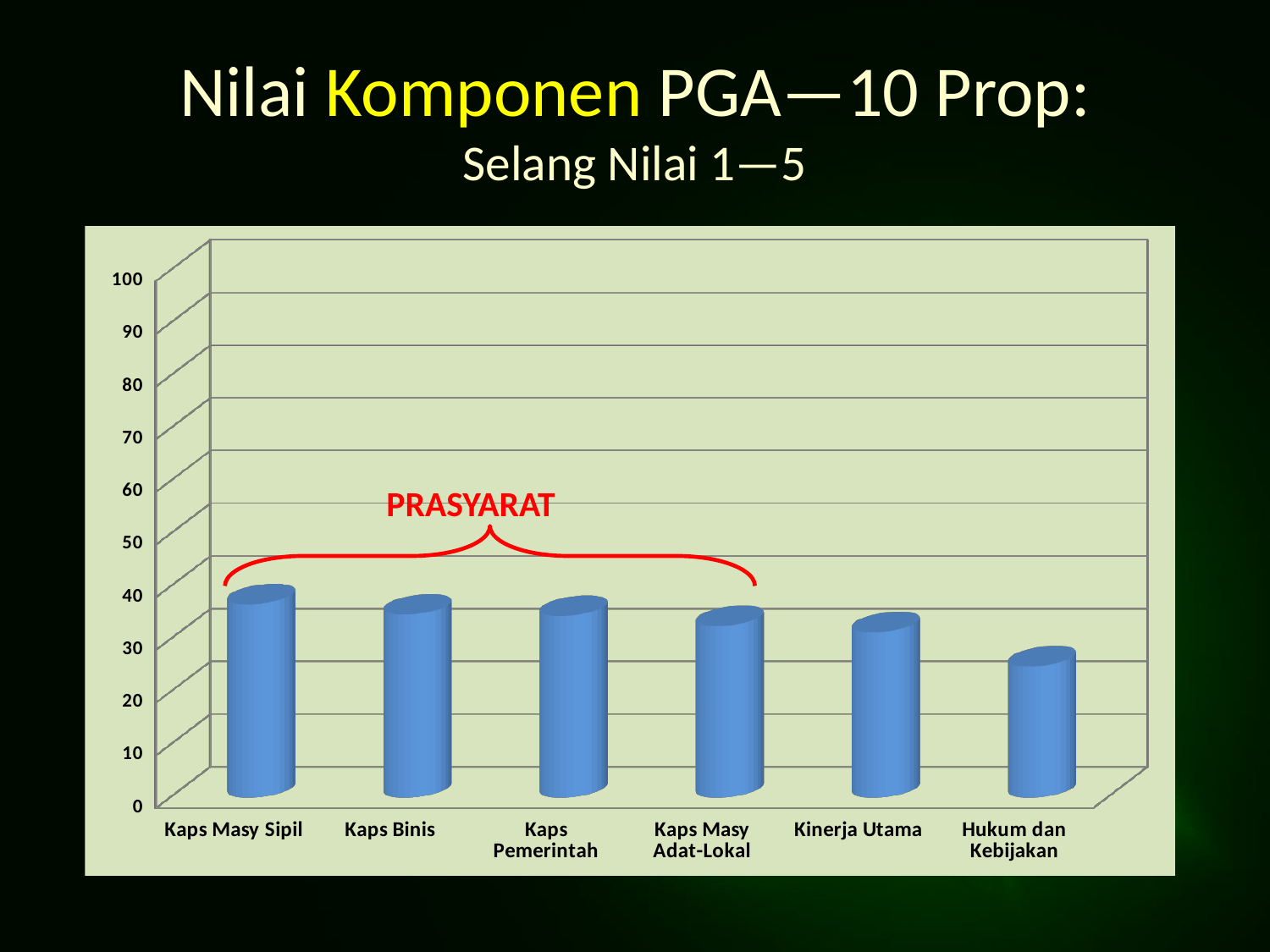
Which is larger, the value for Kaps Masy Sipil or the value for Kinerja Utama? Kaps Masy Sipil What label is written in red above the bracket grouping the first four bars? PRASYARAT What kind of chart is shown on the slide? Bar chart Do the bar values generally rise or fall from left to right along the x axis? Fall Is the value for Hukum dan Kebijakan greater or less than 20? greater Which category has the lowest bar in the chart? Hukum dan Kebijakan Which is larger, the value for Kaps Masy Sipil or the value for Hukum dan Kebijakan? Kaps Masy Sipil Is the value for Hukum dan Kebijakan greater or less than 30? less How many categories are shown on the x axis of the chart? 6 Is the value for Kaps Masy Sipil greater or less than 30? greater Which category has the highest bar in the chart? Kaps Masy Sipil